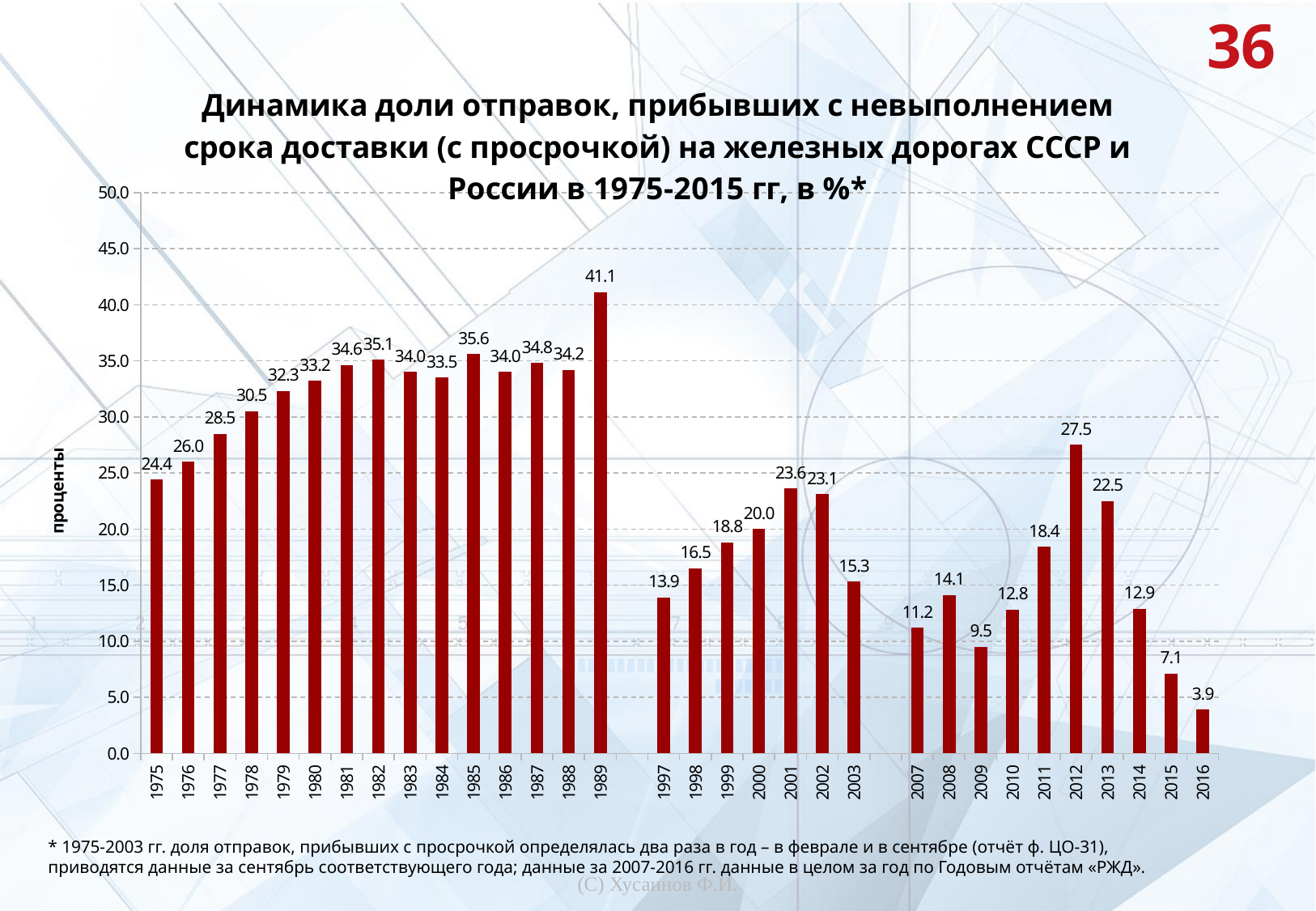
Which is larger, the value for 2001 or the value for 2002? 2001 What kind of chart is shown on the slide? bar chart How many years (bars) are shown on the chart? 32 Do the values rise or fall from 1975 to 1982? rise Which year has the highest value? 1989 What is the value for 2012? 27.5 What is the value for 1997? 13.9 What is the difference between the values for 2012 and 2013? 5.0 Which year has the lowest value? 2016 What is the difference between the values for 1989 and 2016? 37.2 What is the value for 1989? 41.1 Is the value for 2009 greater or less than 10.0? less